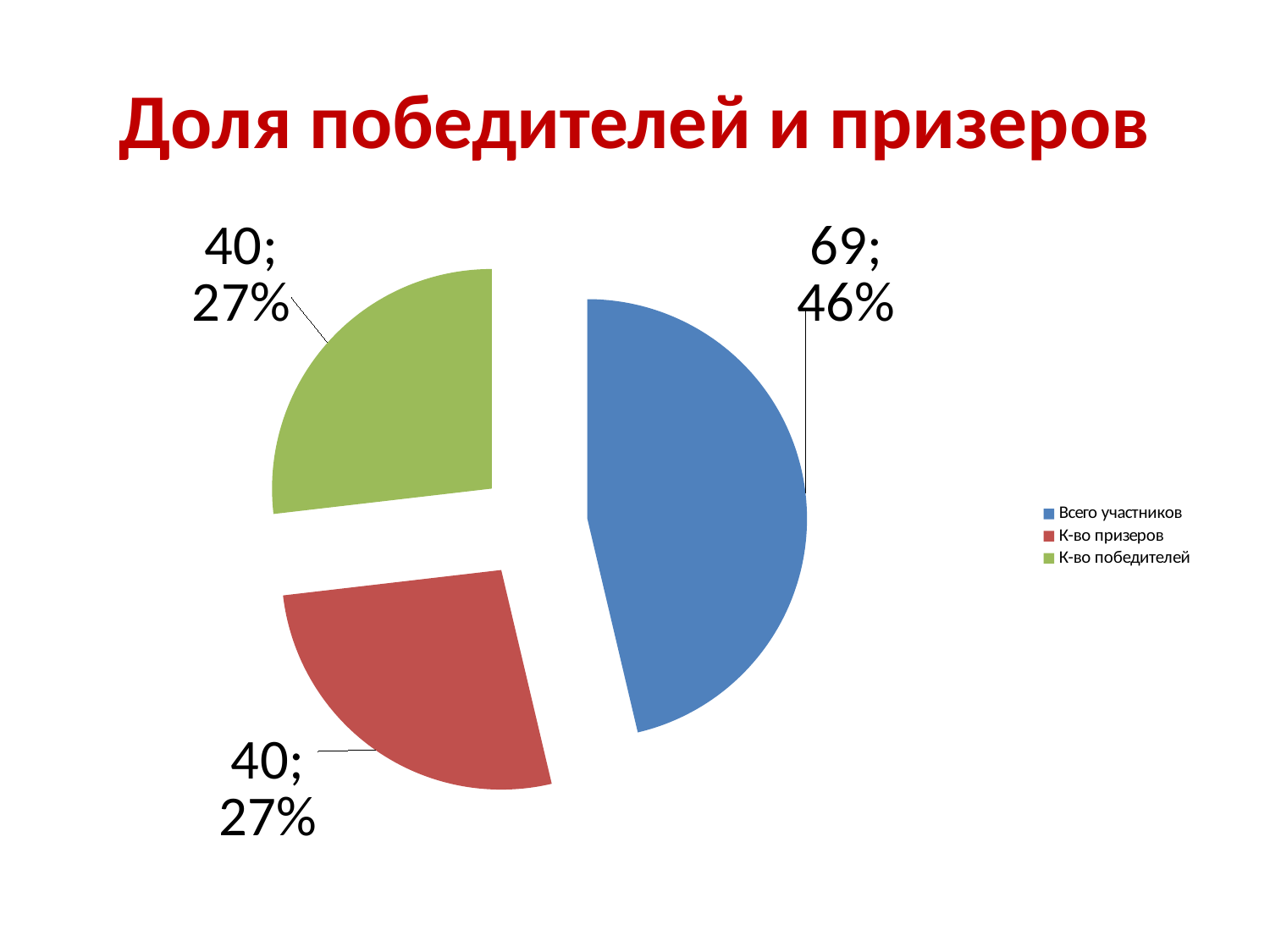
What is the value for Всего участников? 69 What is the title of the chart? Доля победителей и призеров Which category has the largest slice of the pie? Всего участников Which is larger, the value for Всего участников or the value for К-во победителей? Всего участников How many slices does the pie chart have? 3 What share of the pie does К-во победителей represent? 27% What type of chart is shown on the slide? pie chart What share of the pie does Всего участников represent? 46% What is the value for К-во призеров? 40 How many entries does the legend list? 3 What is the value for К-во победителей? 40 What is the difference between the values for Всего участников and К-во призеров? 29